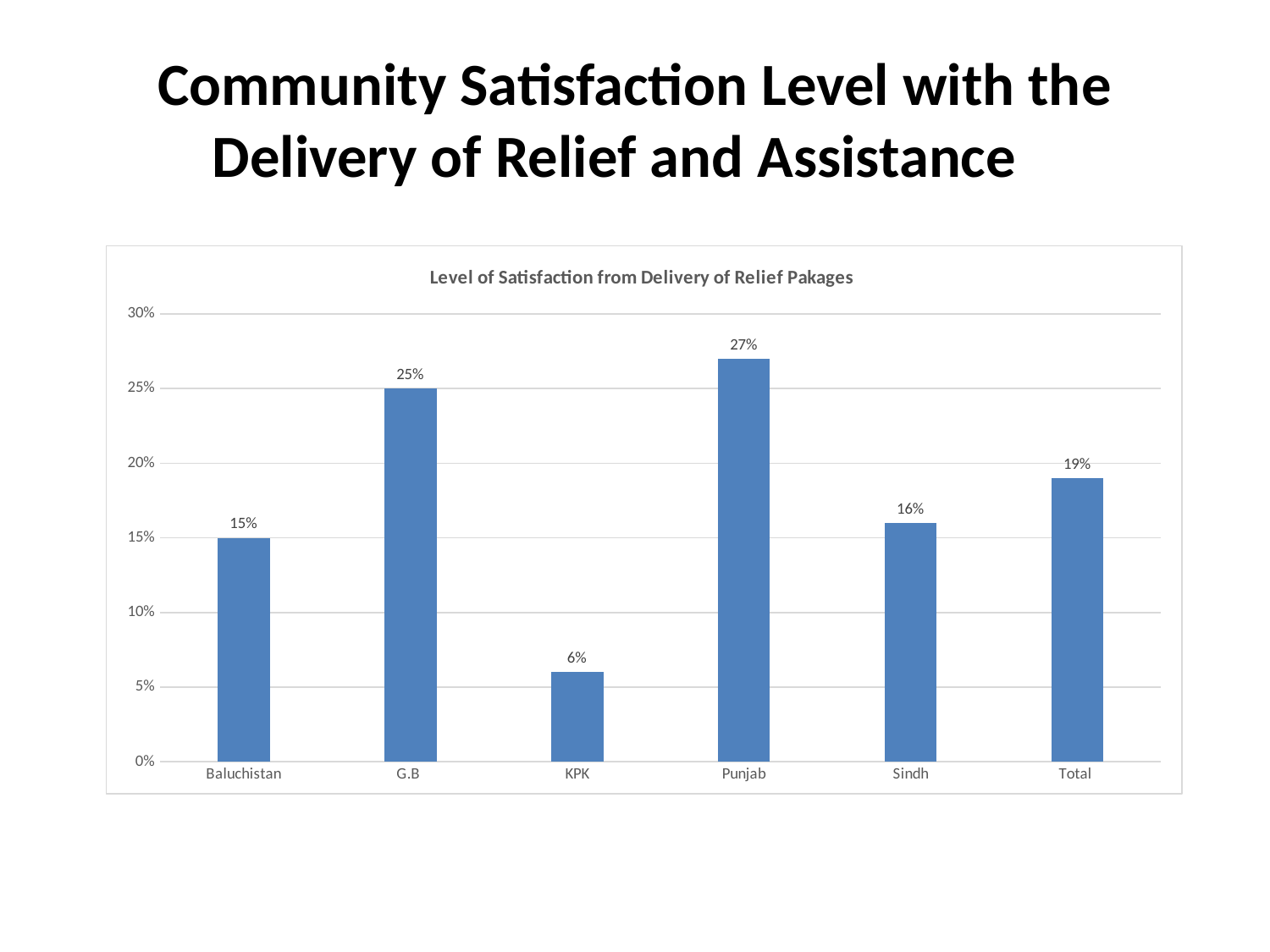
What is the satisfaction level for KPK? 6% What type of chart is shown on the slide? Bar chart Which category has the highest satisfaction level? Punjab What is the satisfaction level for Sindh? 16% Which has a higher satisfaction level, Baluchistan or Sindh? Sindh Which category has the lowest satisfaction level? KPK What is the satisfaction level for Baluchistan? 15% Is the value for Punjab greater or less than 25%? greater What is the difference between the satisfaction levels of Punjab and G.B? 2% What is the difference between the satisfaction levels of G.B and KPK? 19% How many categories are shown on the x axis of the chart? 6 What is the Total satisfaction level shown in the chart? 19%